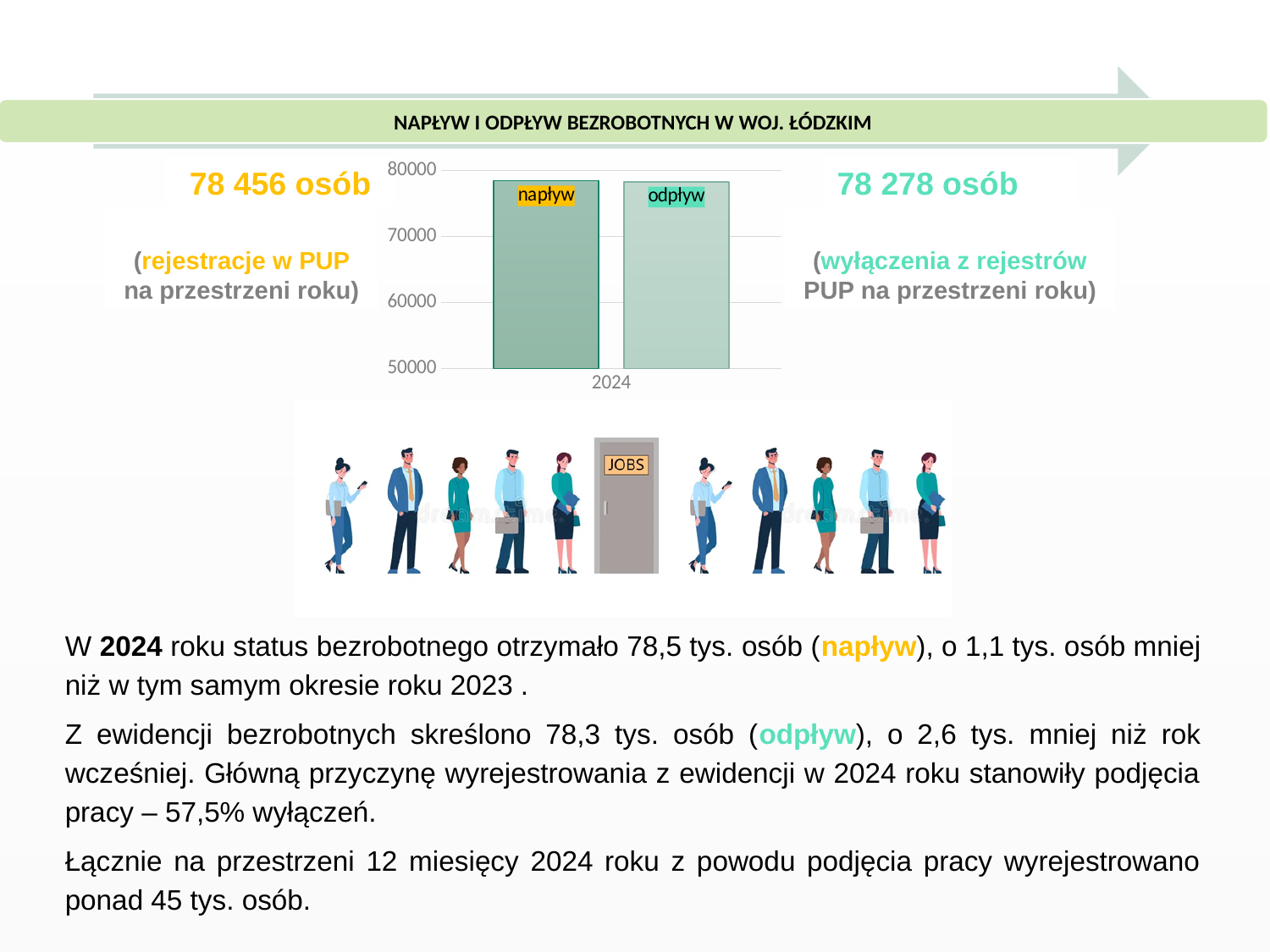
Is the value for napływ greater or less than 70000? greater Which bar is the lowest in the chart? odpływ What kind of chart is shown on the slide? bar chart Which is larger, napływ or odpływ? napływ How many bars are plotted in the chart? 2 What is the value for odpływ in 2024? 78 278 osób What is the difference between napływ and odpływ? 178 osób What is the lowest value shown on the y axis of the chart? 50000 What is the value for napływ in 2024? 78 456 osób Which year is shown on the x axis of the chart? 2024 Is the value for odpływ greater or less than 80000? less